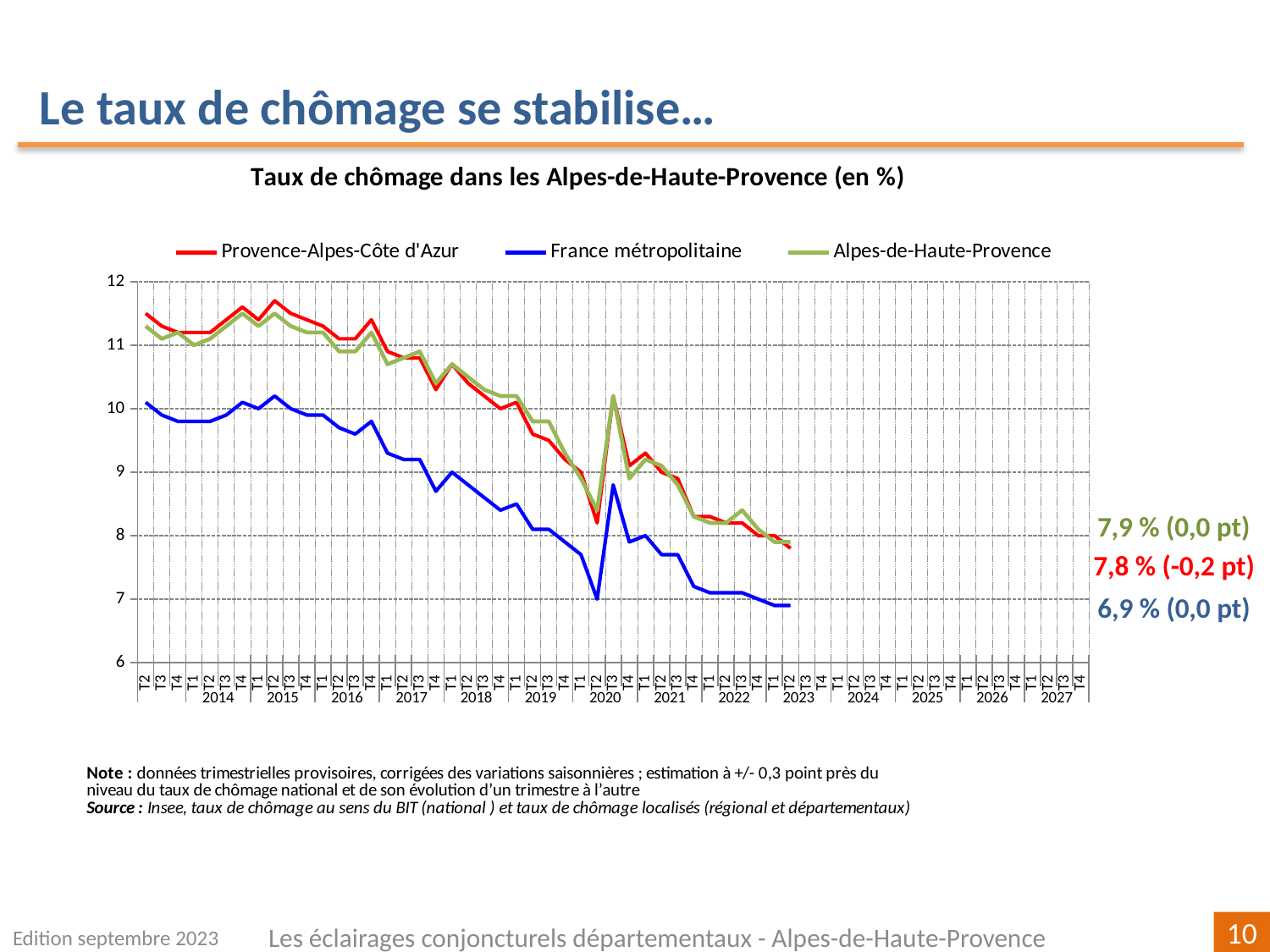
What colour is the France métropolitaine line? blue What kind of chart is shown on the slide? line chart At the latest point, which is higher: Provence-Alpes-Côte d'Azur or France métropolitaine? Provence-Alpes-Côte d'Azur What is the difference between the latest rates for Alpes-de-Haute-Provence and France métropolitaine? 1,0 point How many series does the legend list? 3 What is the latest unemployment rate shown for Alpes-de-Haute-Provence? 7,9 % Overall, does the France métropolitaine line rise or fall from 2014 to 2023? fall What is the latest unemployment rate shown for France métropolitaine? 6,9 % Which series has the lowest values across the whole period? France métropolitaine Is the value for Provence-Alpes-Côte d'Azur in T2 2015 greater or less than 11? greater What quarter-on-quarter change is shown for Provence-Alpes-Côte d'Azur at the latest point? -0,2 pt What is the latest unemployment rate shown for Provence-Alpes-Côte d'Azur? 7,8 %